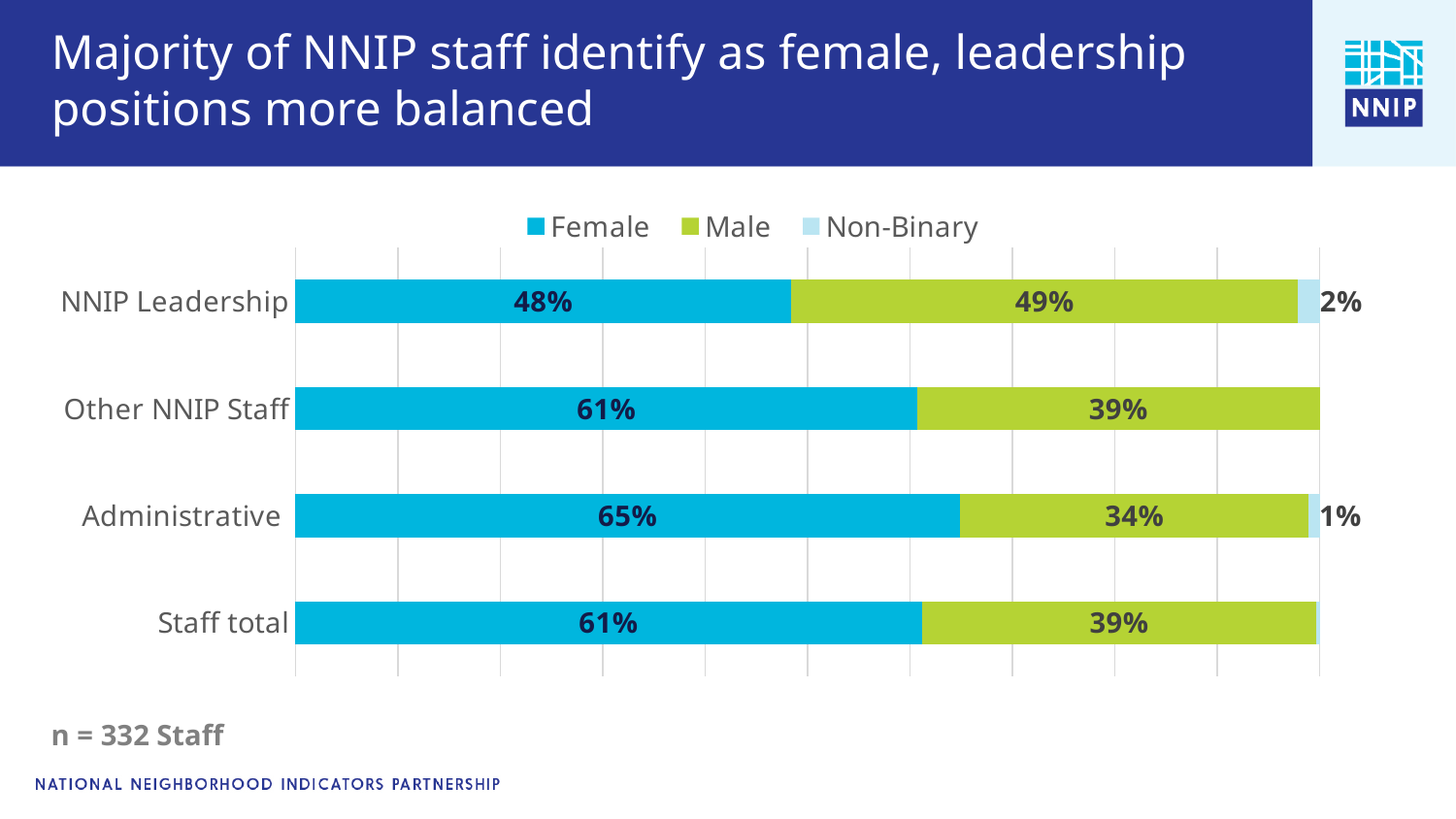
What sample size is noted below the chart? n = 332 Staff Which category has the lowest female percentage? NNIP Leadership What percentage of Administrative staff identify as male? 34% What is the Non-Binary share for NNIP Leadership? 2% What is the difference between the female percentage for Administrative and for NNIP Leadership? 17% Is the male percentage larger for NNIP Leadership or for Staff total? NNIP Leadership What percentage of NNIP Leadership identify as female? 48% What percentage of Other NNIP Staff identify as female? 61% How many categories are shown on the chart? 4 How many series does the legend list? 3 Which category has the highest female percentage? Administrative What kind of chart is shown on the slide? Stacked bar chart